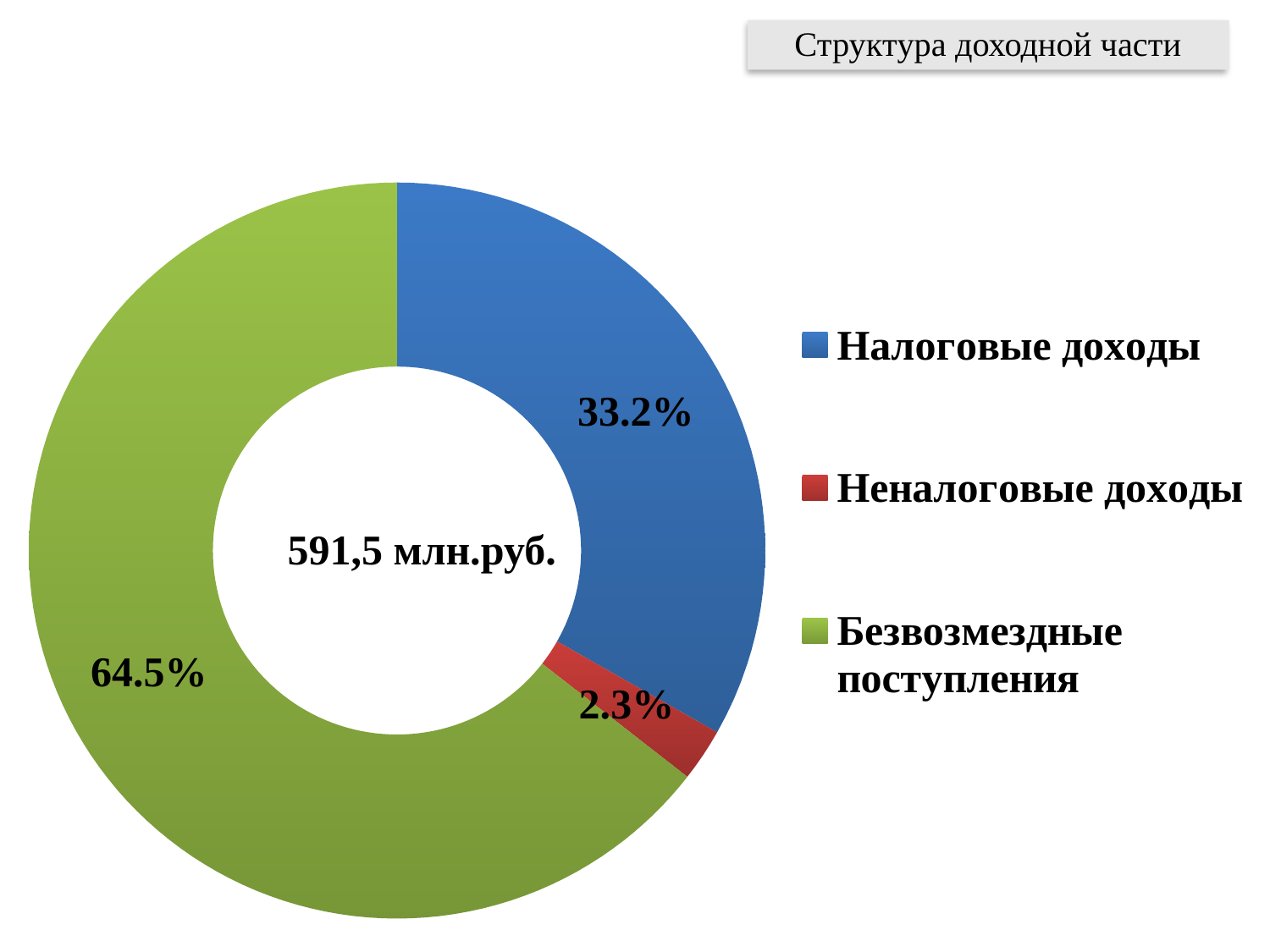
Which category has the largest share of the chart? Безвозмездные поступления How many categories are shown in the chart? 3 What total value is printed in the centre of the chart? 591,5 млн.руб. What is the difference in share between Безвозмездные поступления and Налоговые доходы? 31.3% What share of the chart does Неналоговые доходы have? 2.3% What share of the chart does Безвозмездные поступления have? 64.5% What kind of chart is shown on the slide? Doughnut (pie) chart What share of the chart does Налоговые доходы have? 33.2% Which has a larger share, Налоговые доходы or Неналоговые доходы? Налоговые доходы What is the difference in share between Налоговые доходы and Неналоговые доходы? 30.9% Which category has the smallest share of the chart? Неналоговые доходы What colour represents Безвозмездные поступления in the chart? Green